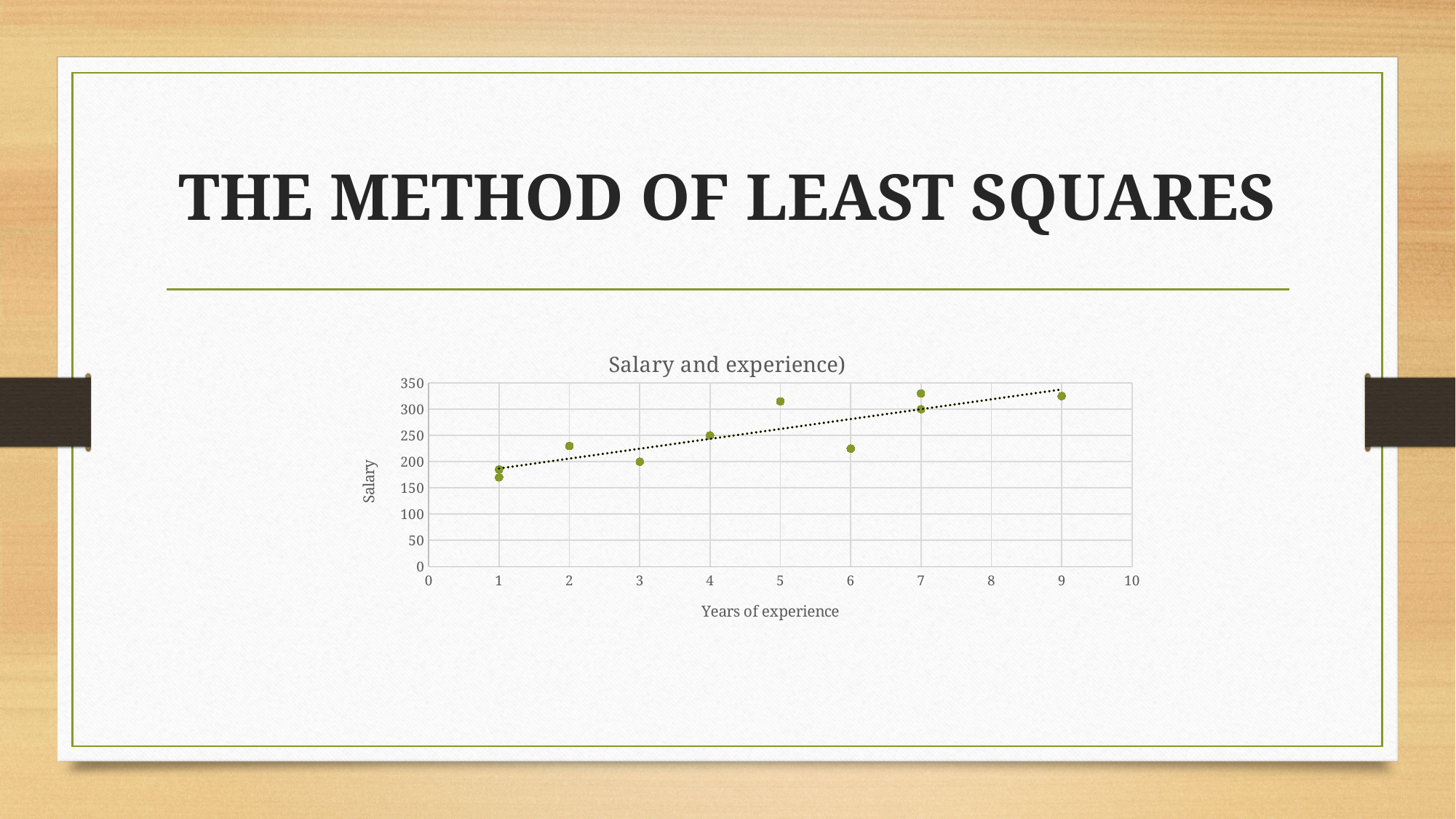
What is the label of the horizontal axis of the chart? Years of experience Is the salary for the point at 9 years of experience greater or less than 300? greater Which point has the lowest salary: the lowest point at 1 year of experience or the point at 3 years of experience? The lowest point at 1 year of experience Which has the higher salary: the point at 5 years of experience or the point at 6 years of experience? 5 years of experience What is the title of the chart? Salary and experience) What kind of chart is shown on the slide? Scatter chart Do the salary values generally rise or fall as years of experience increase? Rise What is the salary value for the point at 4 years of experience? 250 Is the salary for the point at 6 years of experience greater or less than 250? less How many data points are plotted on the chart? 10 What is the salary value for the point at 3 years of experience? 200 Is the salary for the point at 5 years of experience greater or less than 300? greater